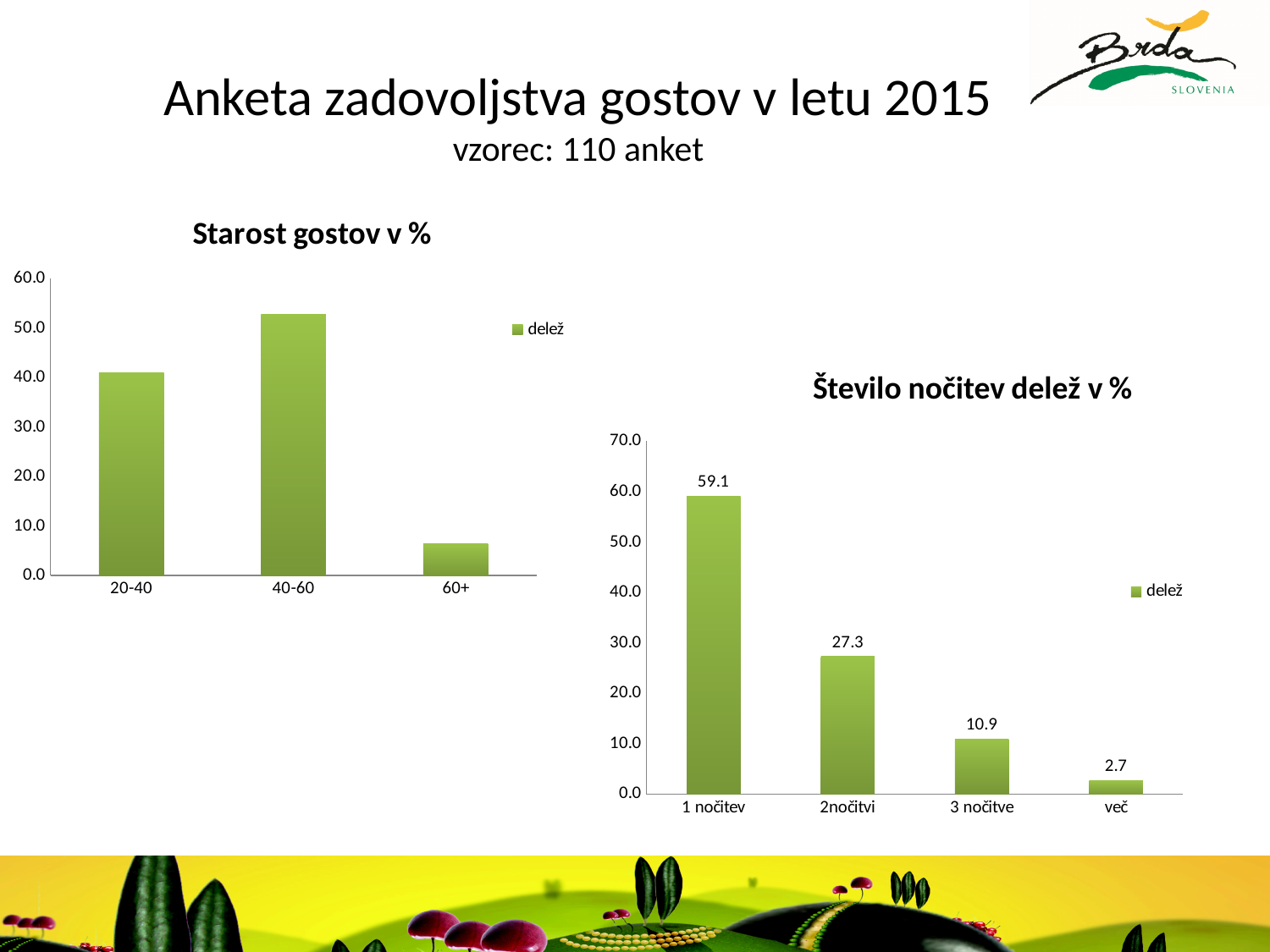
In the chart titled "Število nočitev delež v %", which category has the lowest value? več In the chart titled "Število nočitev delež v %", what is the value for "1 nočitev"? 59.1 In the chart titled "Starost gostov v %", is the value for "60+" greater or less than 10.0? less In the chart titled "Število nočitev delež v %", what is the difference between the values for "1 nočitev" and "2nočitvi"? 31.8 In the chart titled "Starost gostov v %", which age group has the lowest value? 60+ In the chart titled "Število nočitev delež v %", what is the value for "3 nočitve"? 10.9 In the chart titled "Starost gostov v %", is the value for "40-60" greater or less than 50.0? greater What kind of chart is the chart titled "Starost gostov v %"? bar chart In the chart titled "Število nočitev delež v %", do the values rise or fall from left to right along the x axis? fall In the chart titled "Število nočitev delež v %", what is the value for "več"? 2.7 In the chart titled "Število nočitev delež v %", how many categories are shown on the x axis? 4 In the chart titled "Starost gostov v %", which age group has the highest value? 40-60